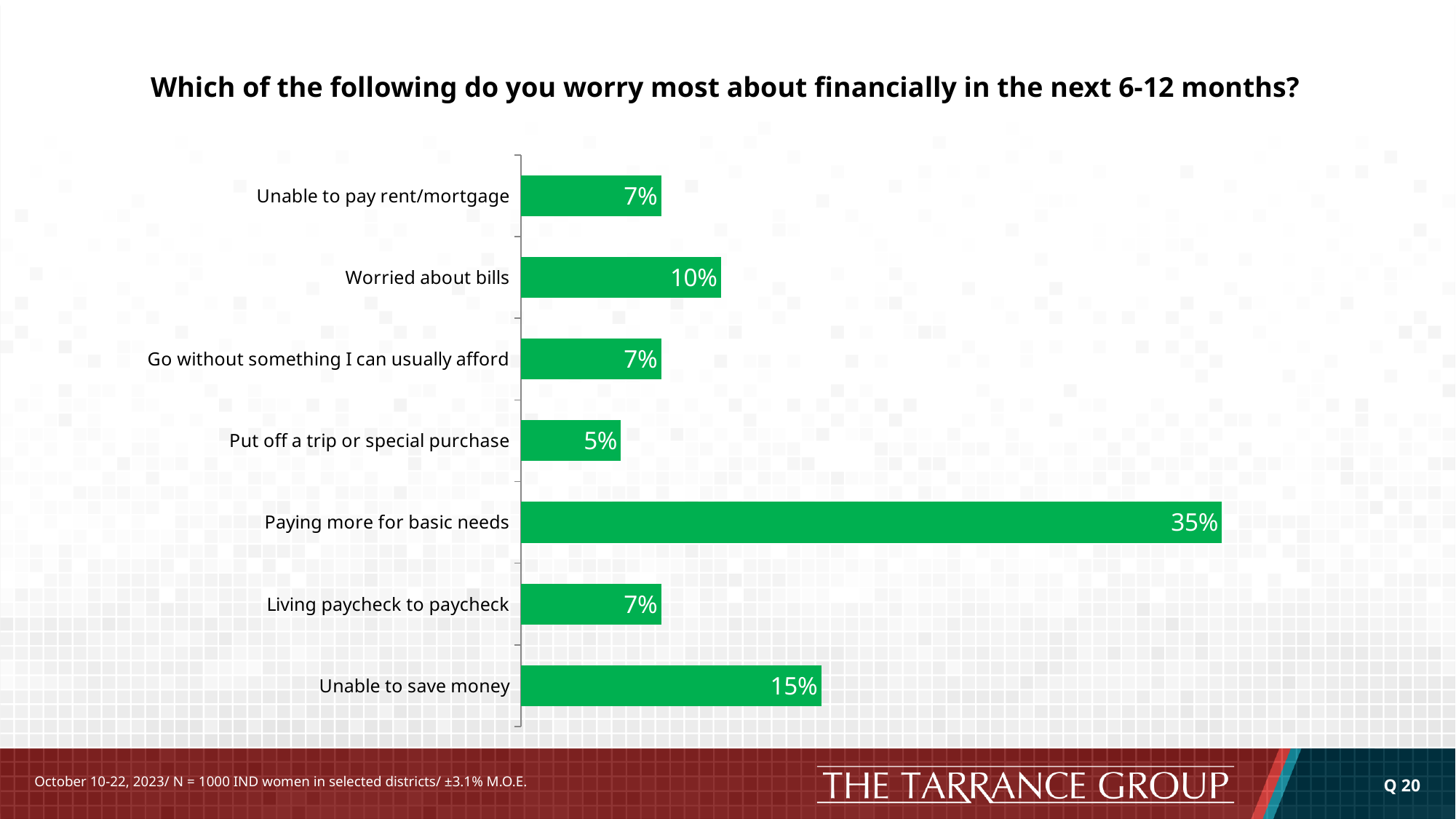
What is the value for "Unable to save money"? 15% What kind of chart is shown on the slide? Bar chart What percentage of respondents worry most about paying more for basic needs? 35% How many categories are shown in the chart? 7 What is the value for "Worried about bills"? 10% Which category has the highest value? Paying more for basic needs Which category has the lowest value? Put off a trip or special purchase What is the value for "Put off a trip or special purchase"? 5% What is the difference between "Worried about bills" and "Put off a trip or special purchase"? 5 percentage points What is the difference between "Paying more for basic needs" and "Unable to save money"? 20 percentage points How many categories share the value 7%? 3 Which is larger, the value for "Unable to save money" or the value for "Worried about bills"? Unable to save money